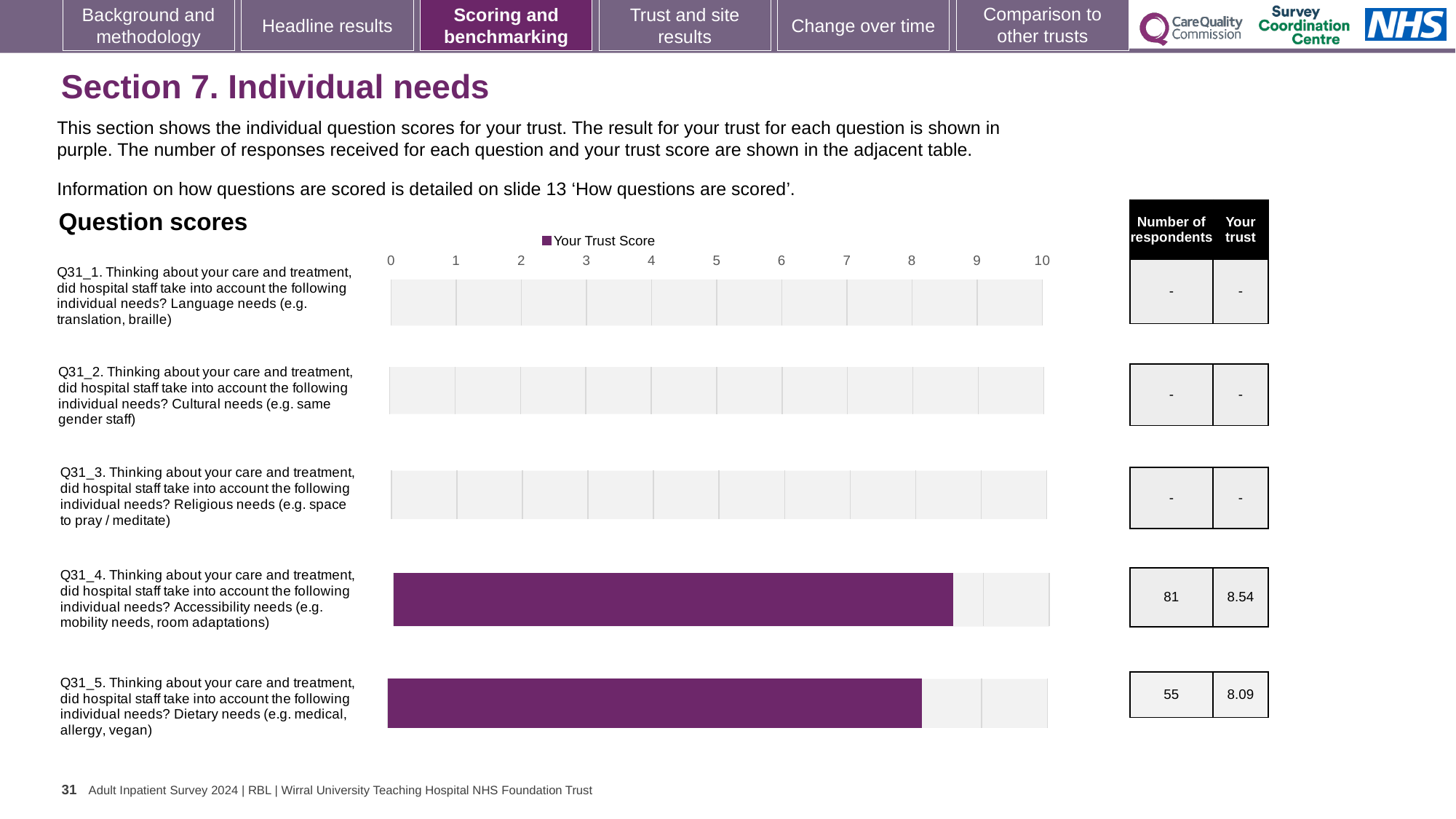
How many respondents answered Q31_4 (Accessibility needs)? 81 How many questions are listed in the Question scores chart? 5 How many respondents answered Q31_5 (Dietary needs)? 55 What is the trust score for Q31_5 (Dietary needs)? 8.09 What kind of chart is used to show the question scores? Bar chart Which question has the higher trust score, Q31_4 (Accessibility needs) or Q31_5 (Dietary needs)? Q31_4 (Accessibility needs) Is the trust score for Q31_5 (Dietary needs) greater or less than 7? greater Is the trust score for Q31_4 (Accessibility needs) greater or less than 8? greater What is the trust score for Q31_4 (Accessibility needs)? 8.54 What is the legend entry shown above the Question scores chart? Your Trust Score How many series does the legend of the Question scores chart list? 1 What is the difference between the trust scores for Q31_4 (Accessibility needs) and Q31_5 (Dietary needs)? 0.45